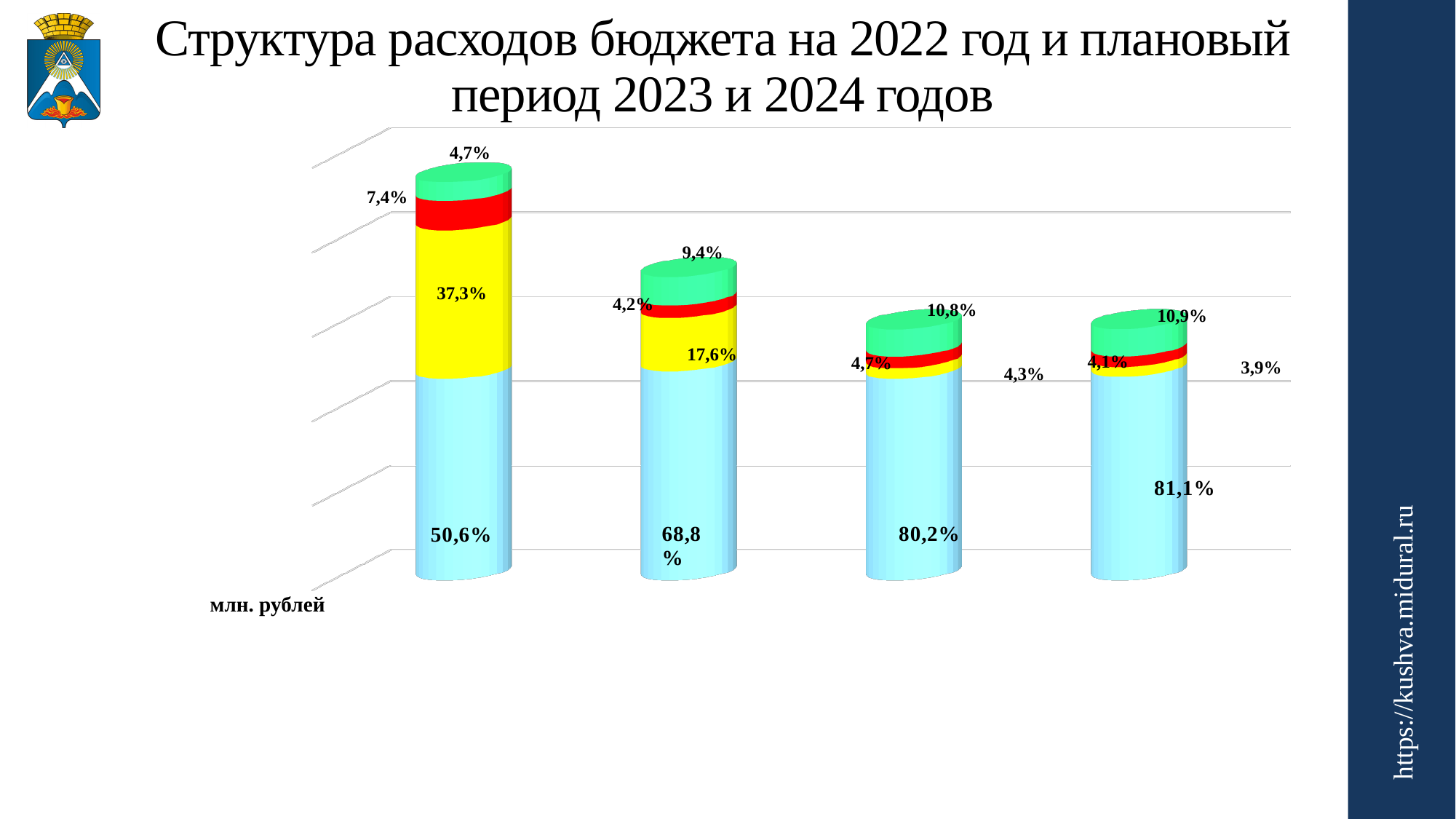
How many stacked bars are plotted in the chart? 4 Which bar has the largest light blue segment? the fourth (rightmost) bar, 81,1% What is the value of the light blue segment of the first (leftmost) bar? 50,6% Which is larger: the green segment of the first bar or the green segment of the second bar? the second bar (9,4%) What is the difference between the yellow segment of the first bar (37,3%) and the yellow segment of the second bar (17,6%)? 19,7% What kind of chart is shown on the slide? stacked bar chart What is the value of the yellow segment of the second bar from the left? 17,6% Do the light blue segment values rise or fall from the leftmost bar to the rightmost bar? rise What is the value of the red segment of the first (leftmost) bar? 7,4% Which bar has the smallest light blue segment? the first (leftmost) bar, 50,6% What is the title of the slide containing the chart? Структура расходов бюджета на 2022 год и плановый период 2023 и 2024 годов What is the value of the green segment at the top of the fourth (rightmost) bar? 10,9%